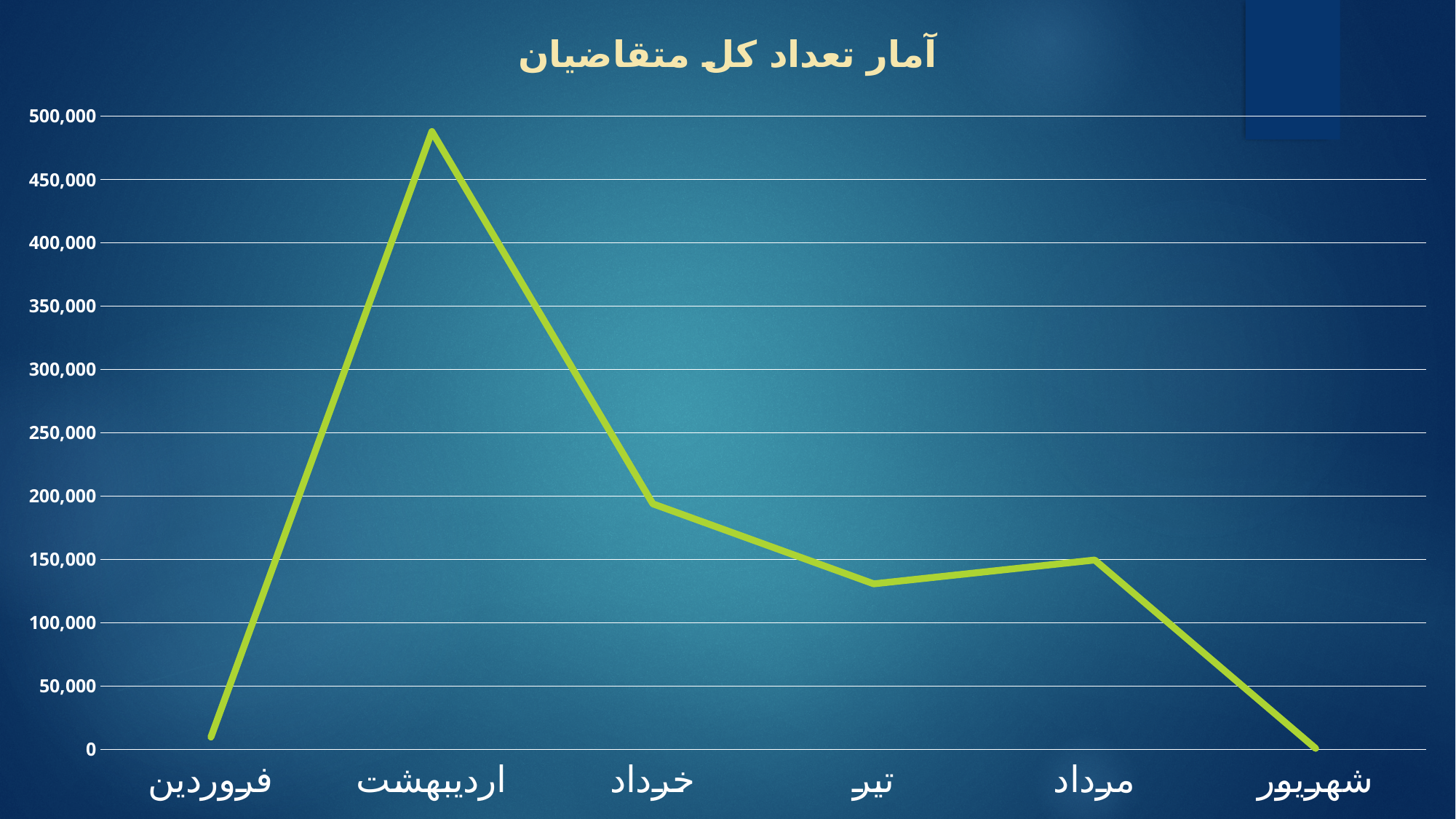
Is the value for مرداد greater or less than 100,000? greater Which is larger, the value for مرداد or the value for تیر? مرداد What is the title of the chart? آمار تعداد کل متقاضیان What kind of chart is shown on the slide? line chart Is the value for تیر greater or less than 150,000? less Which is larger, the value for اردیبهشت or the value for خرداد? اردیبهشت Is the value for اردیبهشت greater or less than 450,000? greater Do the values rise or fall from فروردین to اردیبهشت? rise Which month has the highest value? اردیبهشت How many categories (months) are shown on the x axis? 6